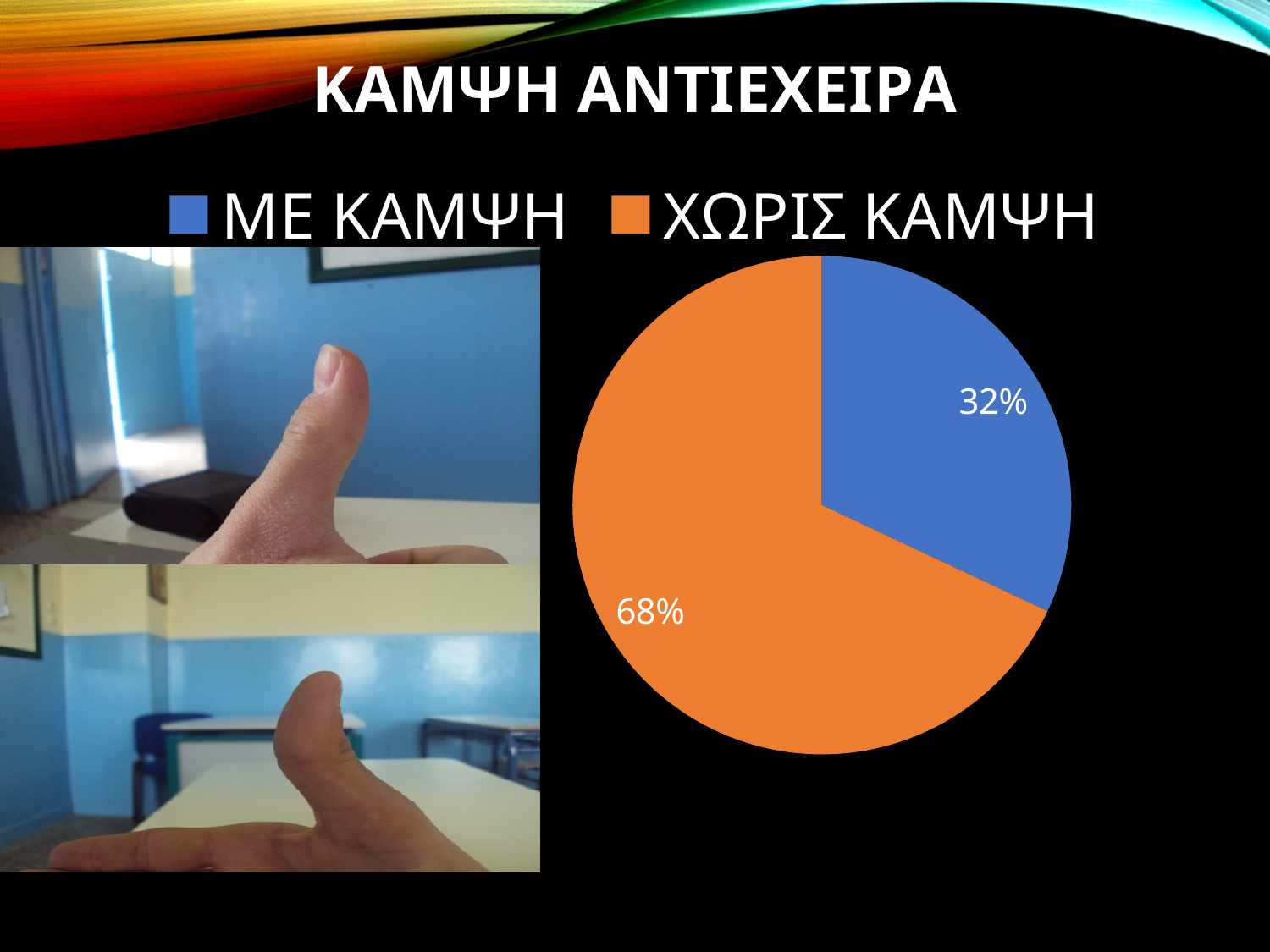
What is the title of the slide containing the chart? ΚΑΜΨΗ ΑΝΤΙΕΧΕΙΡΑ How many entries does the legend list? 2 Which category has the smallest share of the pie? ΜΕ ΚΑΜΨΗ How many slices does the pie chart have? 2 What is the difference in percentage points between ΧΩΡΙΣ ΚΑΜΨΗ and ΜΕ ΚΑΜΨΗ? 36 What percentage is shown for ΜΕ ΚΑΜΨΗ? 32% What colour is the slice for ΜΕ ΚΑΜΨΗ? blue Which is larger, the share for ΜΕ ΚΑΜΨΗ or the share for ΧΩΡΙΣ ΚΑΜΨΗ? ΧΩΡΙΣ ΚΑΜΨΗ What kind of chart is shown on the slide? pie chart Which category has the largest share of the pie? ΧΩΡΙΣ ΚΑΜΨΗ What percentage is shown for ΧΩΡΙΣ ΚΑΜΨΗ? 68% What share of the pie does the ΧΩΡΙΣ ΚΑΜΨΗ slice represent? 68%